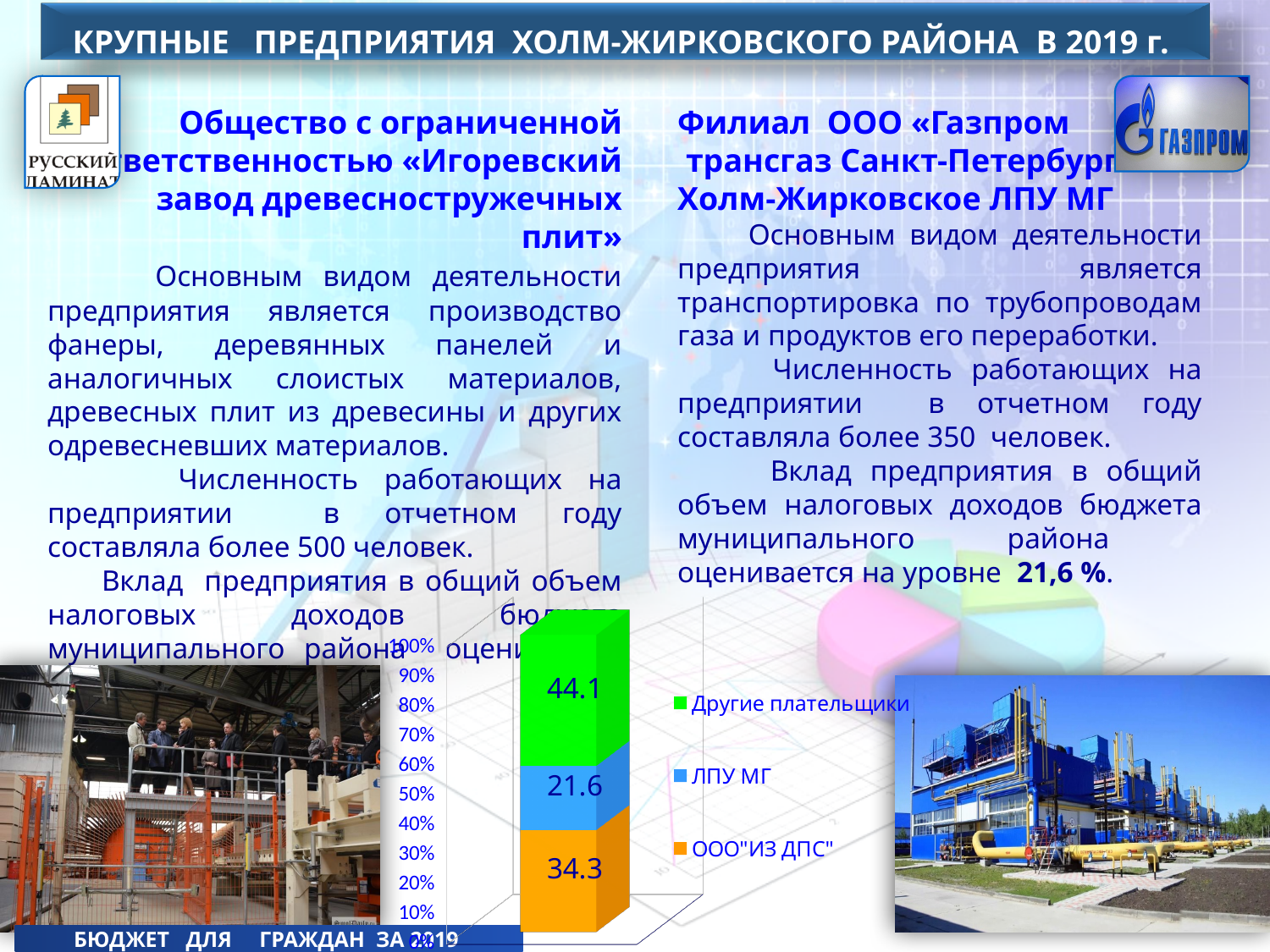
Which is larger: the "ООО"ИЗ ДПС"" segment or the "ЛПУ МГ" segment? ООО"ИЗ ДПС" Which legend entry has the largest segment in the stacked bar? Другие плательщики Which legend entry has the smallest segment in the stacked bar? ЛПУ МГ What is the value of the "Другие плательщики" segment in the stacked bar? 44.1 What is the highest tick label shown on the vertical axis of the chart? 100% What colour is the "ЛПУ МГ" segment in the stacked bar? blue What is the total of all three segments in the stacked bar? 100 What is the value of the "ООО"ИЗ ДПС"" segment in the stacked bar? 34.3 How many series does the chart legend list? 3 What kind of chart is shown on the slide? stacked bar chart What is the difference between the "Другие плательщики" segment and the "ЛПУ МГ" segment? 22.5 What is the value of the "ЛПУ МГ" segment in the stacked bar? 21.6